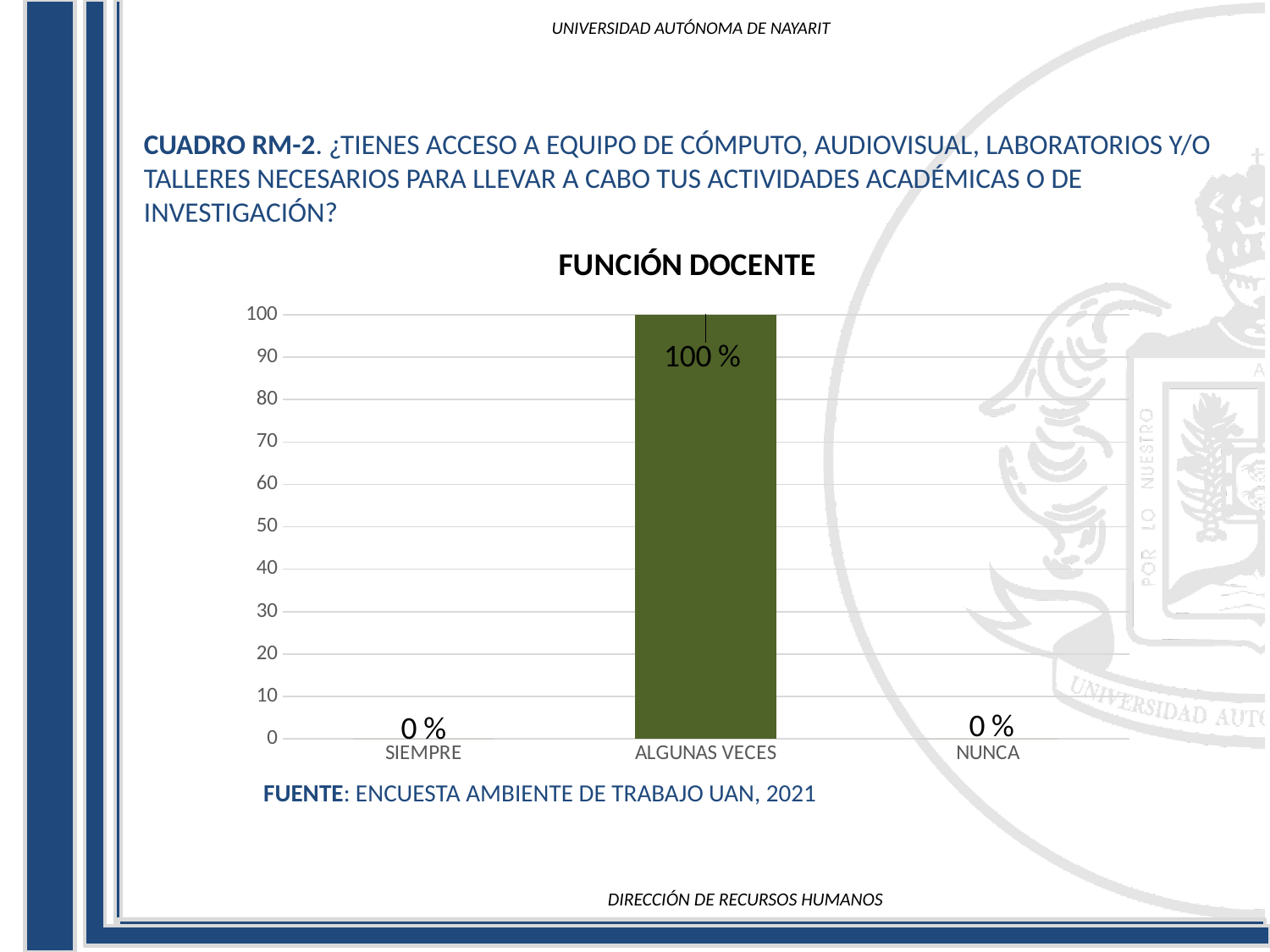
Which is larger, the value for ALGUNAS VECES or the value for NUNCA? ALGUNAS VECES What is the value for SIEMPRE? 0 % What kind of chart is shown on the slide? bar chart Which category has the highest value? ALGUNAS VECES What is the value for ALGUNAS VECES? 100 % How many categories are shown on the x axis? 3 What is the highest value shown on the y axis? 100 What is the value for NUNCA? 0 % Is the value for ALGUNAS VECES greater or less than 50? greater What is the title of the chart? FUNCIÓN DOCENTE What is the difference between the values for ALGUNAS VECES and SIEMPRE? 100 %